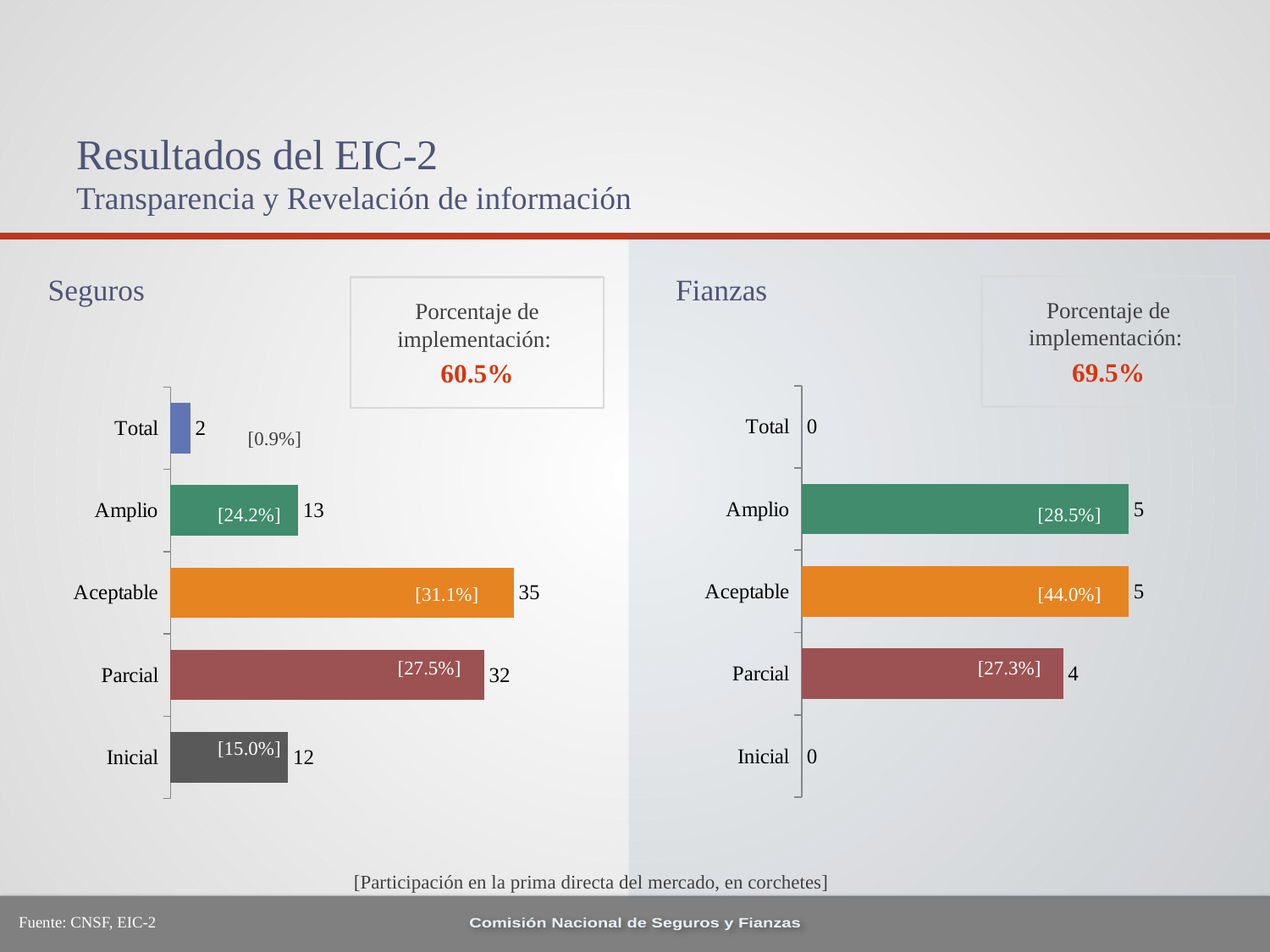
In the Fianzas chart, what is the value for Parcial? 4 What percentage of implementation is shown for Fianzas? 69.5% In the Fianzas chart, which is larger, the value for Amplio or the value for Parcial? Amplio How many categories does the Fianzas chart show? 5 In the Seguros chart, which is larger, the value for Amplio or the value for Inicial? Amplio What kind of chart is the Seguros chart? Bar chart In the Seguros chart, what is the value for Aceptable? 35 In the Fianzas chart, what is the value for Total? 0 In the Seguros chart, what is the value for Inicial? 12 In the Seguros chart, what is the difference between the values for Aceptable and Parcial? 3 In the Seguros chart, which category has the lowest value? Total In the Seguros chart, which category has the highest value? Aceptable